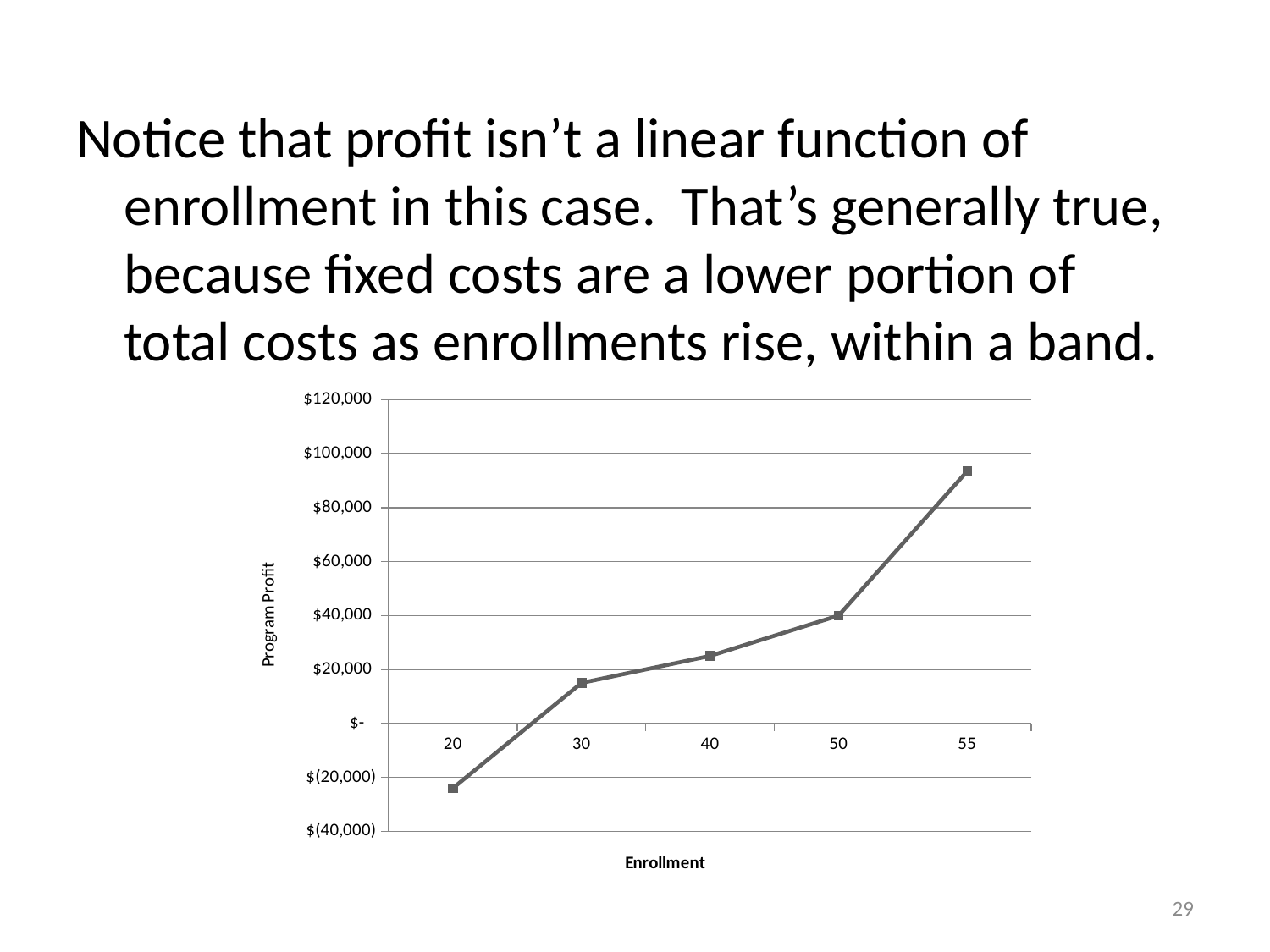
What is the title of the y axis? Program Profit What kind of chart is shown on the slide? line chart At which enrollment level is program profit lowest? 20 What is the title of the x axis? Enrollment Which enrollment level has the larger program profit, 30 or 50? 50 Is the program profit at an enrollment of 30 greater or less than $20,000? less Is the program profit at an enrollment of 20 greater or less than $0? less Does program profit rise or fall as enrollment increases along the x axis? rise Is the program profit at an enrollment of 40 greater or less than $20,000? greater At which enrollment level is program profit highest? 55 How many enrollment points are plotted on the chart? 5